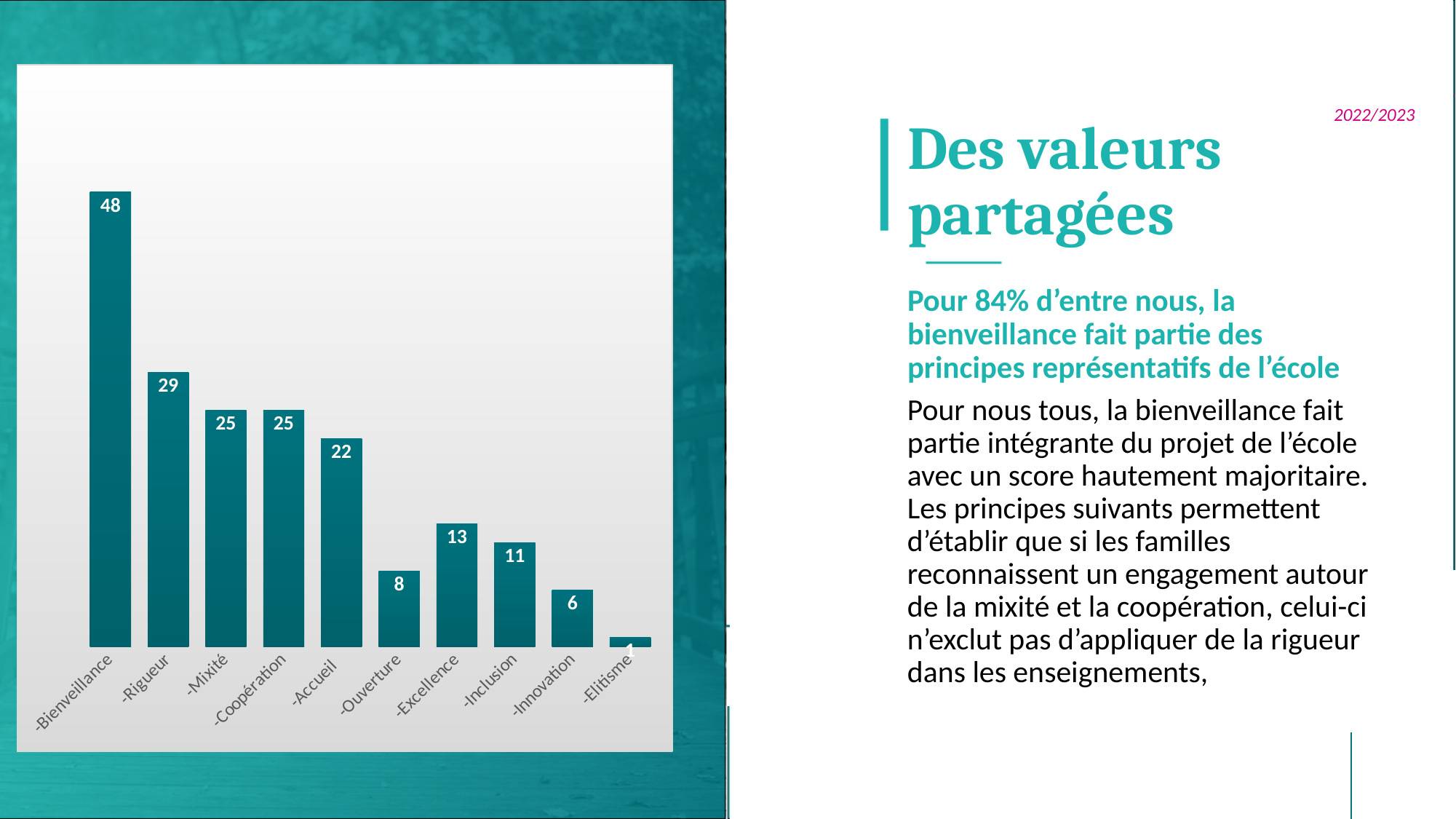
Which category has the lowest value? Elitisme How many categories are shown in the chart? 10 What is the value for Innovation? 6 What is the value for Bienveillance? 48 What is the value for Rigueur? 29 What is the value for Excellence? 13 What is the difference between the values for Bienveillance and Rigueur? 19 What is the difference between the values for Excellence and Ouverture? 5 Which is larger, the value for Inclusion or the value for Ouverture? Inclusion Which category has the highest value? Bienveillance What kind of chart is shown on the slide? Bar chart What is the value for Accueil? 22